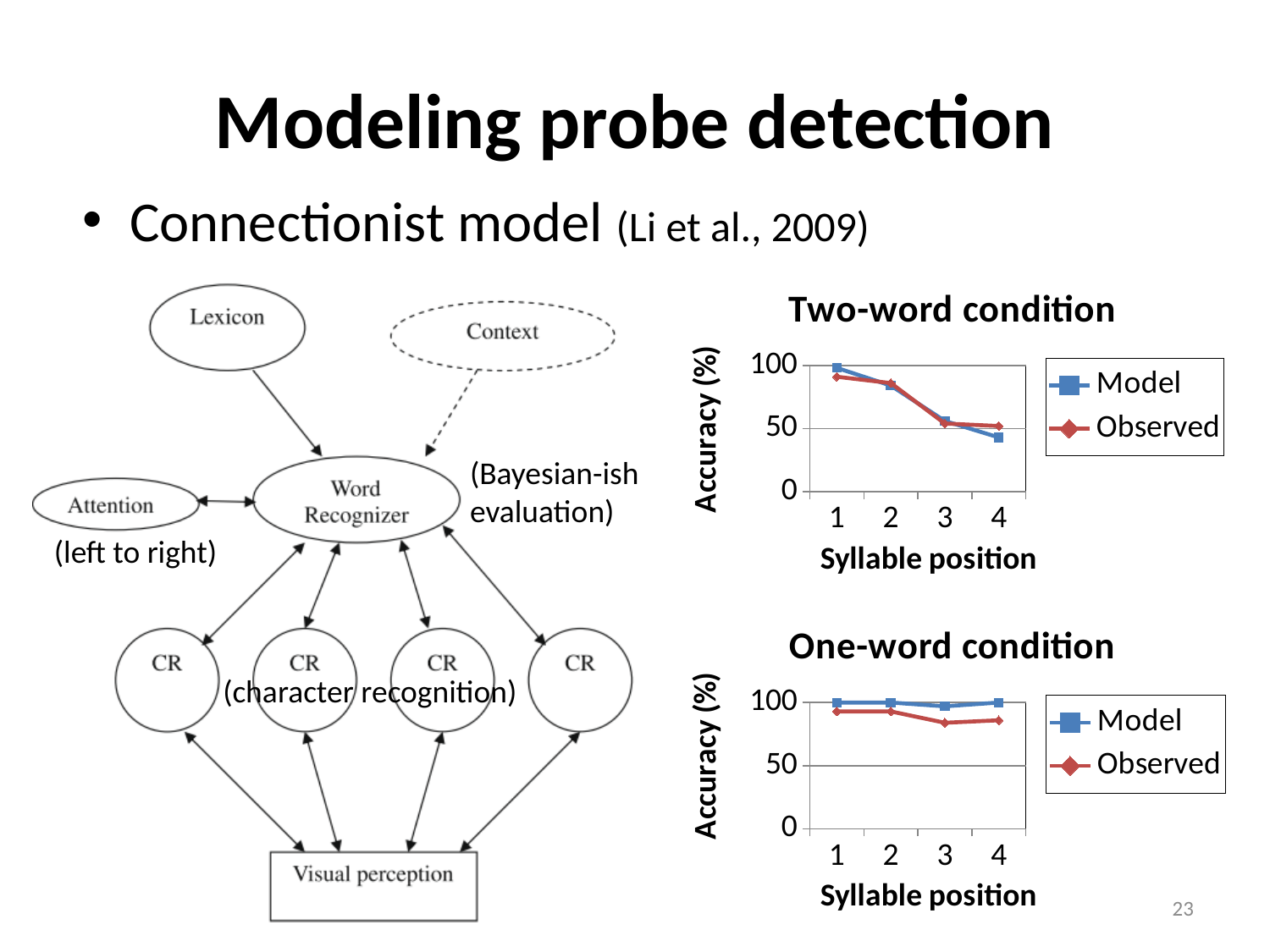
In the "Two-word condition" chart, is the Observed value at syllable position 2 greater or less than 50? greater What kind of chart is the "Two-word condition" chart? line chart How many syllable positions are plotted on the x axis of the "Two-word condition" chart? 4 In the "One-word condition" chart, which series has the higher value at syllable position 3, Model or Observed? Model In the "Two-word condition" chart, which series has the higher value at syllable position 1, Model or Observed? Model How many series does the legend of the "One-word condition" chart list? 2 In the "Two-word condition" chart, is the Model value at syllable position 1 greater or less than 50? greater What is the x-axis title of the "Two-word condition" chart? Syllable position What is the y-axis title of the "One-word condition" chart? Accuracy (%) In the "Two-word condition" chart, is the Model value at syllable position 4 greater or less than 50? less In the "Two-word condition" chart, do the Model values rise or fall as syllable position increases from 1 to 4? fall